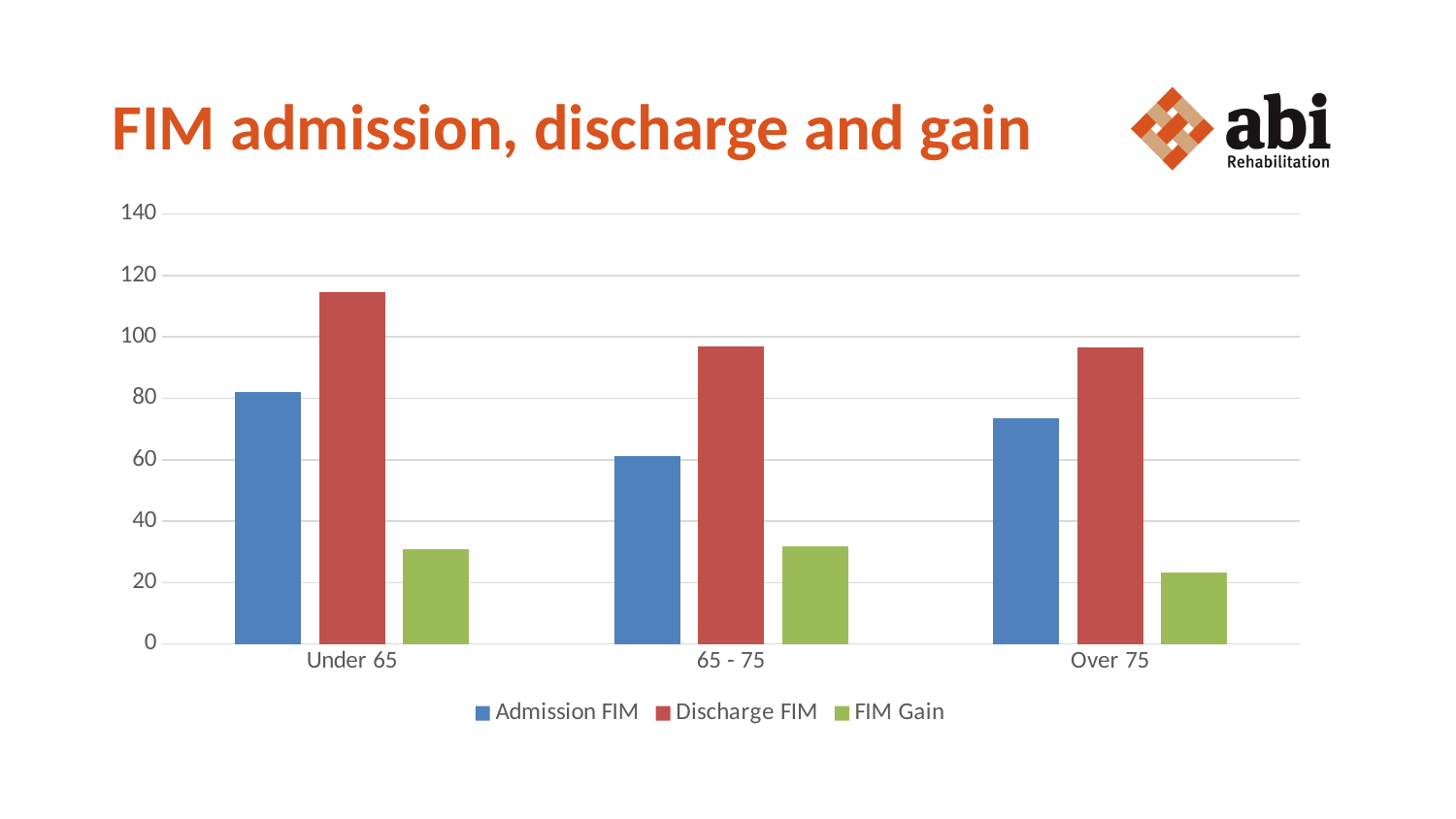
Which is larger: the Admission FIM for Under 65 or the Admission FIM for Over 75? Under 65 How many series does the legend list? 3 What is the title of the slide? FIM admission, discharge and gain Which age group has the highest Admission FIM? Under 65 Is the Admission FIM value for 65 - 75 greater or less than 80? less How many age groups are shown on the x axis? 3 Which age group has the lowest Admission FIM? 65 - 75 What kind of chart is shown on the slide? bar chart Is the Discharge FIM value for Under 65 greater or less than 100? greater Is the FIM Gain value for Over 75 greater or less than 40? less Which age group has the highest Discharge FIM? Under 65 Which age group has the lowest FIM Gain? Over 75